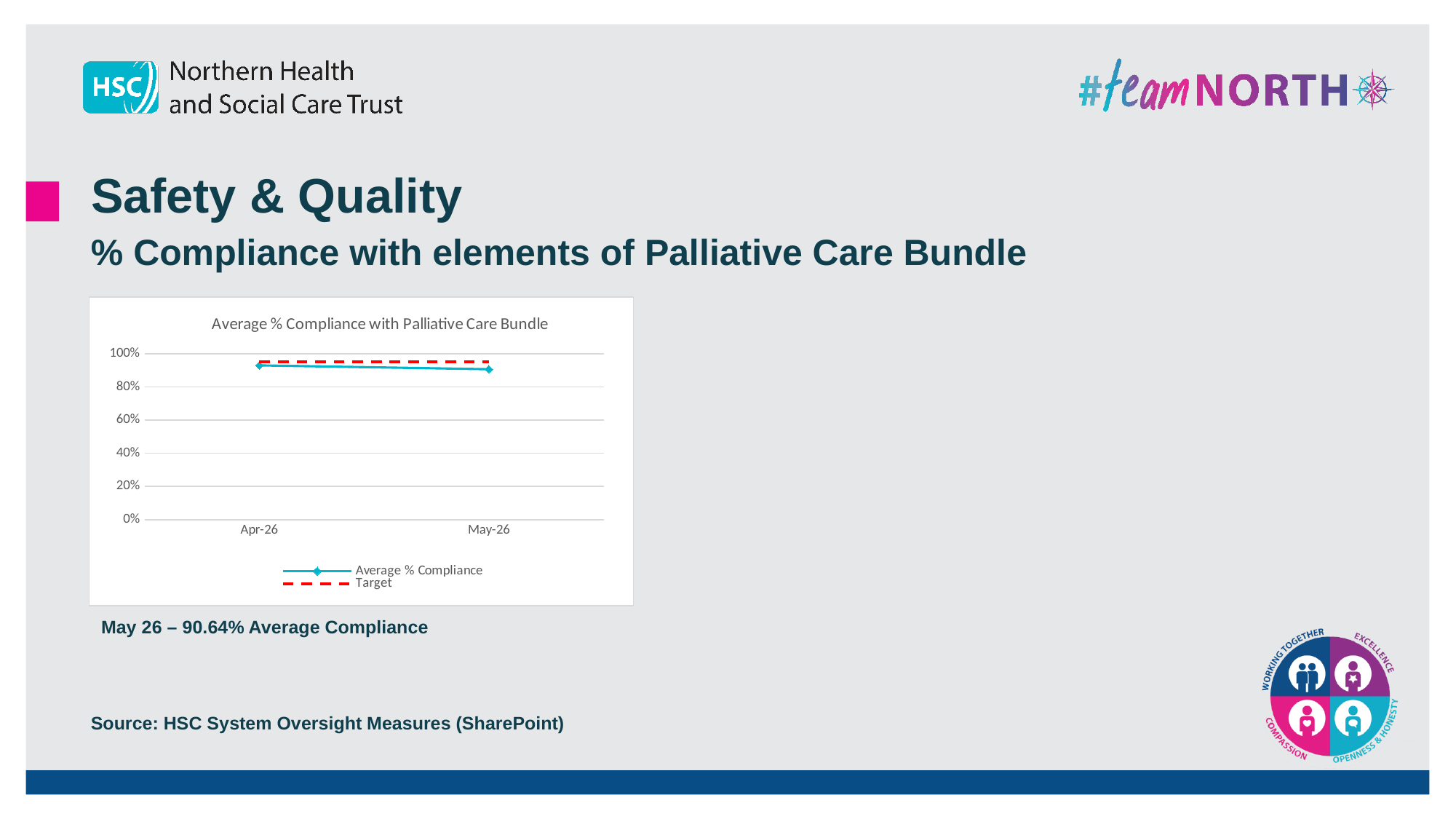
In May-26, which is higher, the Target or the Average % Compliance? Target Is the Target line greater or less than 100%? less Is the Average % Compliance for May-26 greater or less than 80%? greater Which series is drawn as a red dashed line in the chart? Target Does the Average % Compliance line rise or fall from Apr-26 to May-26? fall Which month has the higher Average % Compliance, Apr-26 or May-26? Apr-26 How many series does the chart's legend list? 2 What kind of chart is shown on the slide? line chart What was the Average % Compliance for May-26? 90.64% How many months are plotted on the x axis of the chart? 2 What is the title of the chart? Average % Compliance with Palliative Care Bundle Is the Average % Compliance for Apr-26 greater or less than 80%? greater